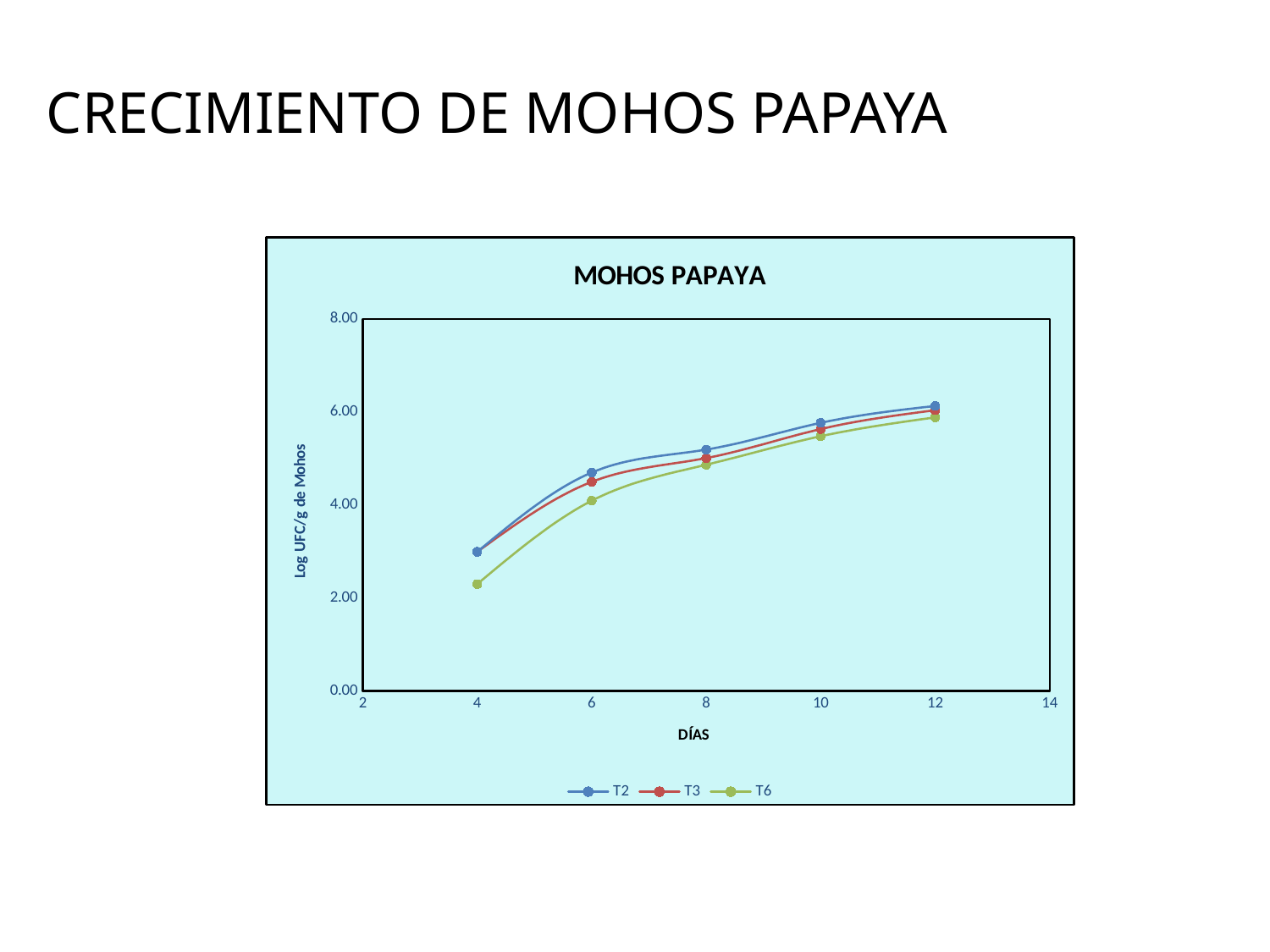
Do the values of the T6 series rise or fall as the days increase? rise Is the value for T3 at day 10 greater or less than 6.00? less Which series are listed in the legend of the MOHOS PAPAYA chart? T2, T3, T6 Is the value for T2 at day 12 greater or less than 4.00? greater How many series does the legend of the MOHOS PAPAYA chart list? 3 Is the value for T6 at day 4 greater or less than 4.00? less At day 4, which series has the higher value, T2 or T6? T2 How many data points does the T2 series have in the MOHOS PAPAYA chart? 5 What kind of chart is shown on the slide? line chart What is the label of the y axis in the MOHOS PAPAYA chart? Log UFC/g de Mohos Which series has the lowest value at day 4? T6